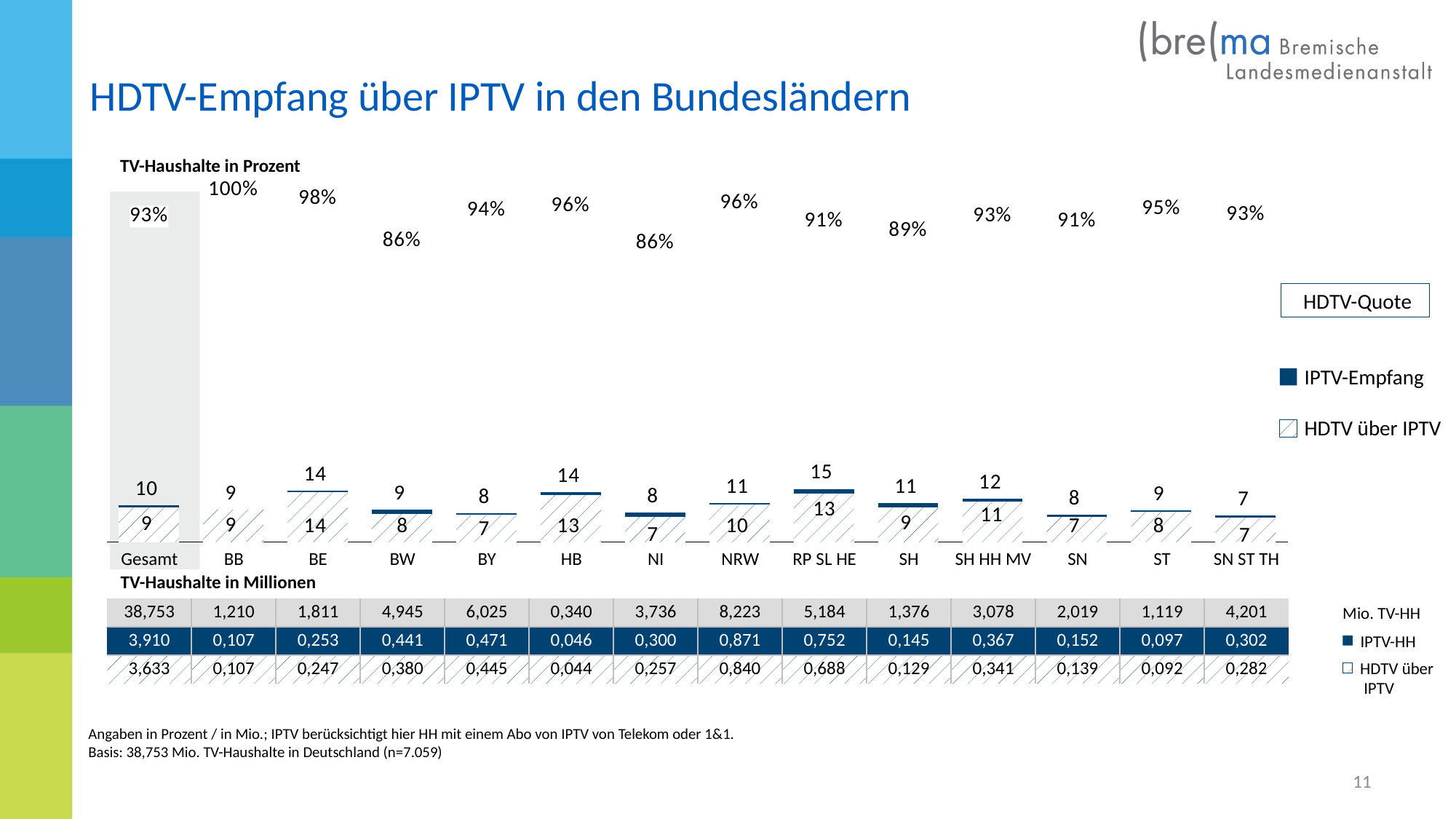
Which category has the highest HDTV-Quote? BB What is the title of the slide? HDTV-Empfang über IPTV in den Bundesländern How many categories are shown on the x axis of the chart? 14 What kind of chart is shown on the slide? Bar chart What is the HDTV-Quote value for BB? 100% Which category has the highest IPTV-Empfang value? RP SL HE Which category has the lowest IPTV-Empfang value? SN ST TH Which is larger, the IPTV-Empfang value for BE or for NRW? BE What is the HDTV über IPTV value for HB? 13 What is the IPTV-Empfang value for RP SL HE? 15 What is the difference between the IPTV-Empfang value and the HDTV über IPTV value for RP SL HE? 2 How many series does the chart legend list? 3